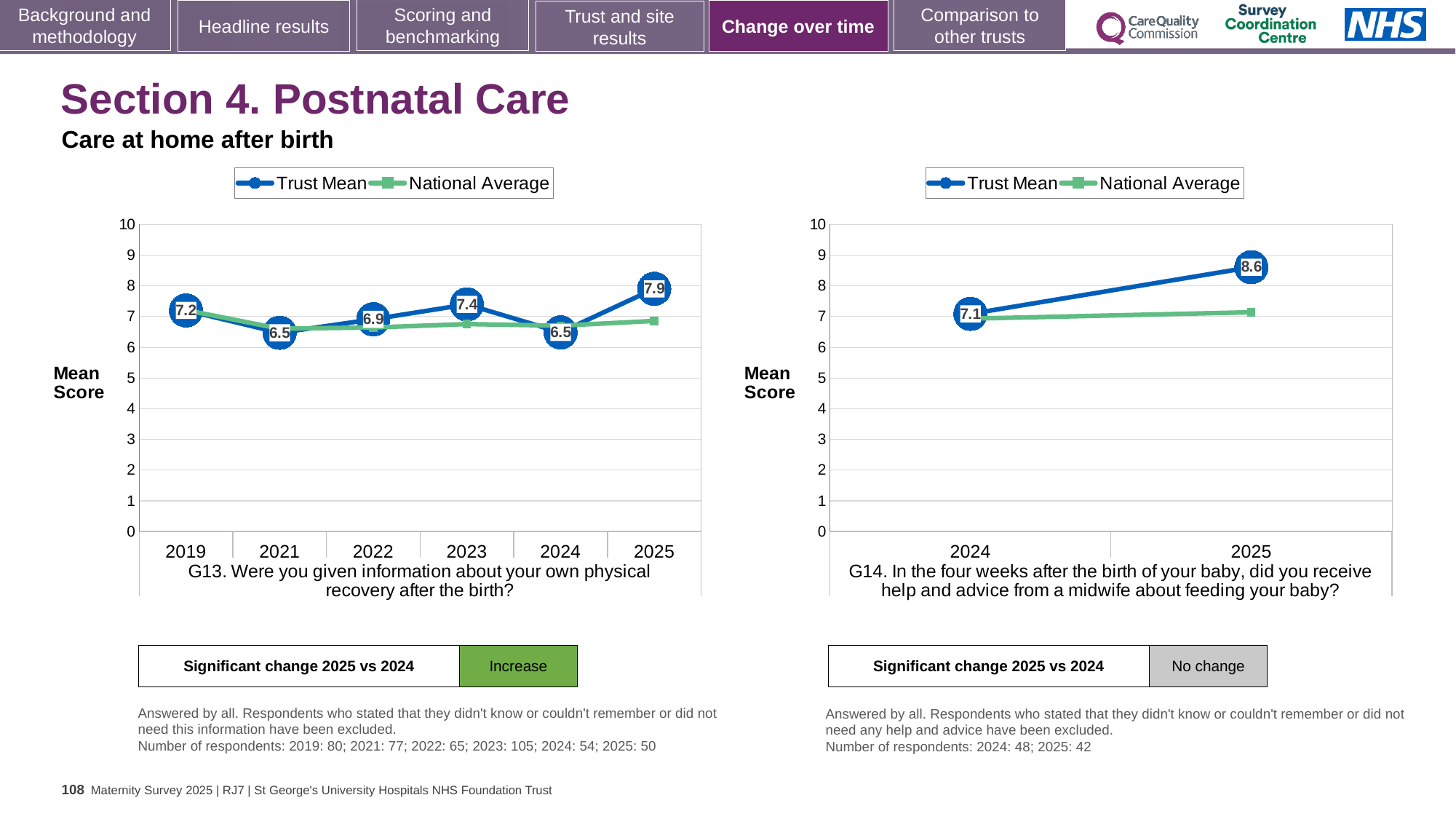
In the G14 chart on the right, does the Trust Mean rise or fall from 2024 to 2025? Rise In the G13 chart on the left, what is the Trust Mean score for 2025? 7.9 What type of chart is the G14 chart on the right? Line chart How many series does the legend of the G14 chart on the right list? 2 In the G14 chart on the right, is the National Average value for 2025 greater or less than 8? less In the G14 chart on the right, what is the difference between the Trust Mean scores for 2025 and 2024? 1.5 In the G13 chart on the left, is the Trust Mean score higher in 2023 or in 2022? 2023 In the G14 chart on the right, what is the Trust Mean score for 2025? 8.6 In the G13 chart on the left, which year has the highest Trust Mean score? 2025 How many years are shown on the x axis of the G13 chart on the left? 6 In the G13 chart on the left, what is the lowest Trust Mean score shown? 6.5 In the G13 chart on the left, what is the Trust Mean score for 2019? 7.2